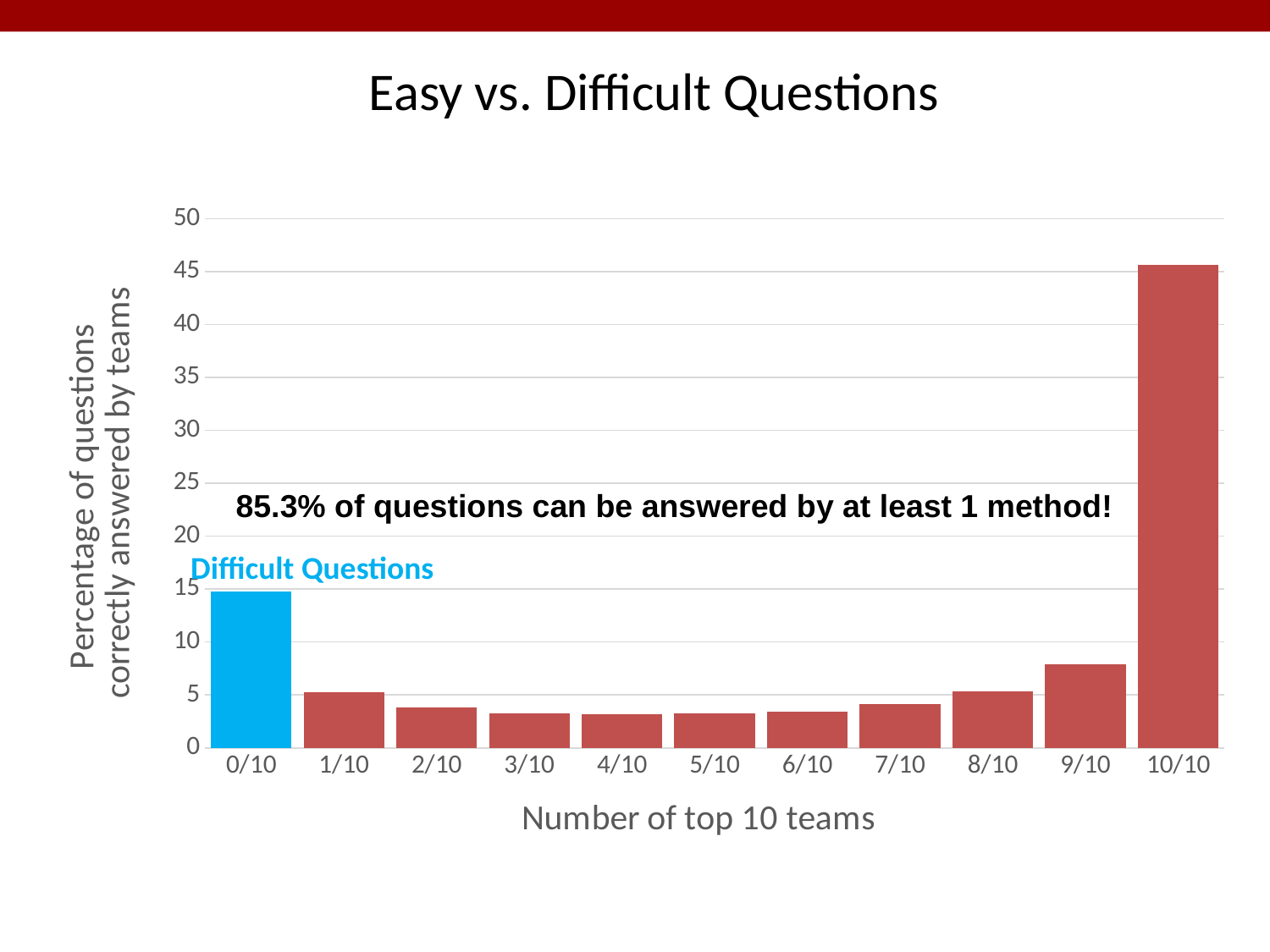
Which category has the highest percentage of questions correctly answered? 10/10 Is the value for 10/10 greater or less than 40? greater Which category's bar is coloured blue and labelled "Difficult Questions"? 0/10 Which is larger, the value for 9/10 or the value for 8/10? 9/10 What kind of chart is shown on the slide? bar chart How many categories are shown on the x axis? 11 Which is larger, the value for 0/10 or the value for 9/10? 0/10 Is the value for 9/10 greater or less than 5? greater What is the title of the x axis? Number of top 10 teams Do the values rise or fall from 5/10 to 10/10 along the x axis? rise Is the value for 0/10 greater or less than 10? greater